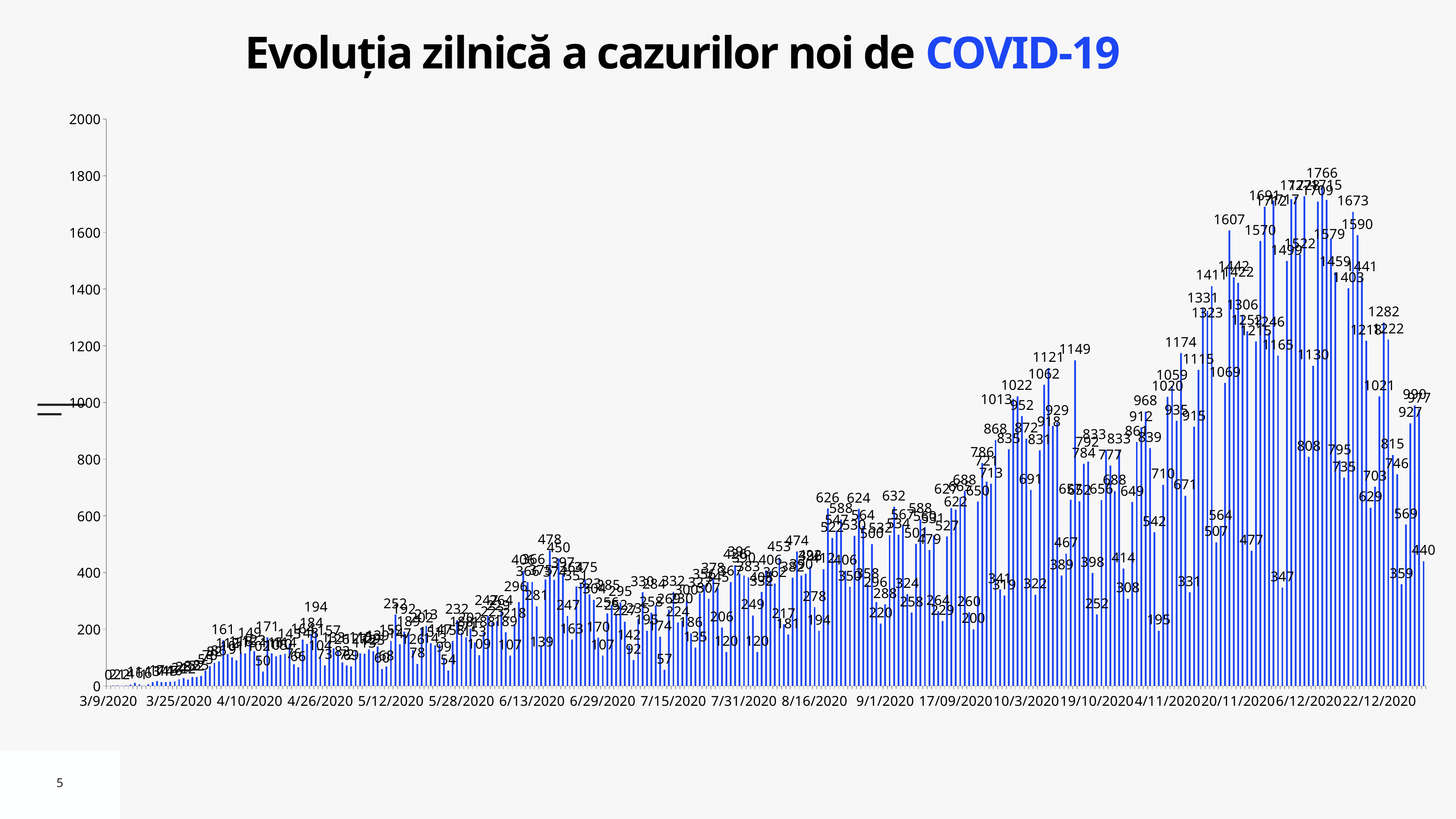
What is the difference between the peak value 1766 and the bar labelled 1673? 93 Is the value for 3/9/2020 greater or less than 200? less What is the title of the chart? Evoluția zilnică a cazurilor noi de COVID-19 Is the value for 5/12/2020 greater or less than 400? less What is the maximum value shown on the vertical axis? 2000 Is the value for 22/12/2020 greater or less than 1000? greater What kind of chart is shown on the slide? bar chart Which is larger, the peak labelled 1766 or the bar labelled 1607? 1766 What is the difference between the peak value 1766 and the bar labelled 1607? 159 What is the highest daily value labelled on the chart? 1766 What is the value of the last bar on the right of the chart? 440 Overall, do the daily values rise or fall from March 2020 to December 2020? rise